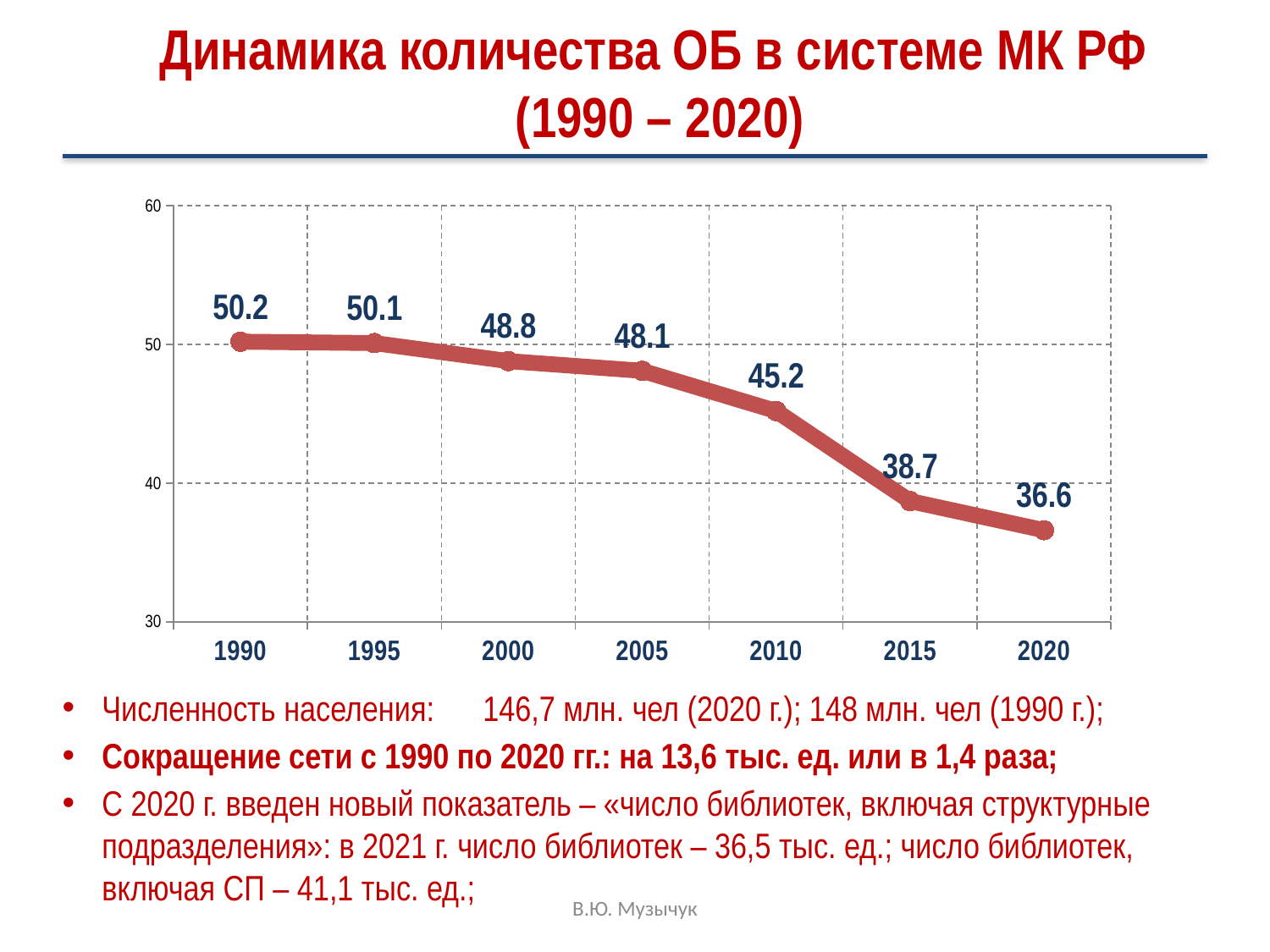
What is the value for 1990? 50.2 Do the values rise or fall from 1990 to 2020? fall What is the difference between the values for 1990 and 2020? 13.6 What is the value for 2010? 45.2 Which year has the highest value? 1990 What is the difference between the values for 2010 and 2015? 6.5 How many years are plotted on the chart? 7 Which year has the lowest value? 2020 What kind of chart is shown on the slide? line chart Is the value for 2015 greater or less than 40? less What is the value for 2020? 36.6 Which is larger, the value for 2005 or the value for 2015? 2005